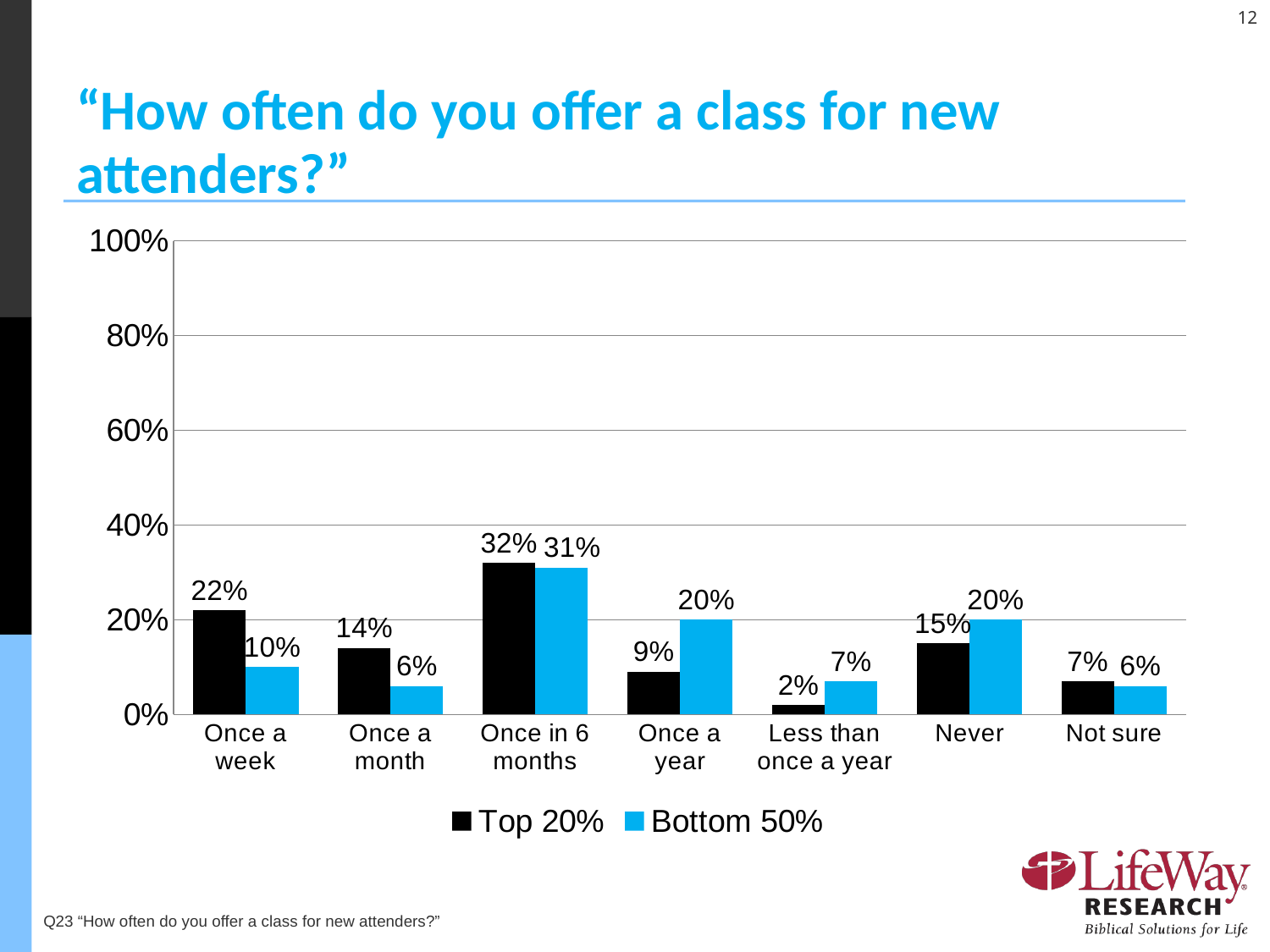
How many series does the legend list? 2 How many categories are shown on the x axis? 7 Is the value for Top 20% for "Once in 6 months" greater or less than 20%? greater Which is larger for "Never": Top 20% or Bottom 50%? Bottom 50% What is the value for Top 20% for "Once a week"? 22% What is the value for Bottom 50% for "Once a year"? 20% What kind of chart is shown on the slide? Bar chart Which category has the highest value for Top 20%? Once in 6 months What is the difference between Top 20% and Bottom 50% for "Once a week"? 12% What is the value for Top 20% for "Less than once a year"? 2% Which category has the lowest value for Top 20%? Less than once a year What is the difference between Bottom 50% and Top 20% for "Once a year"? 11%